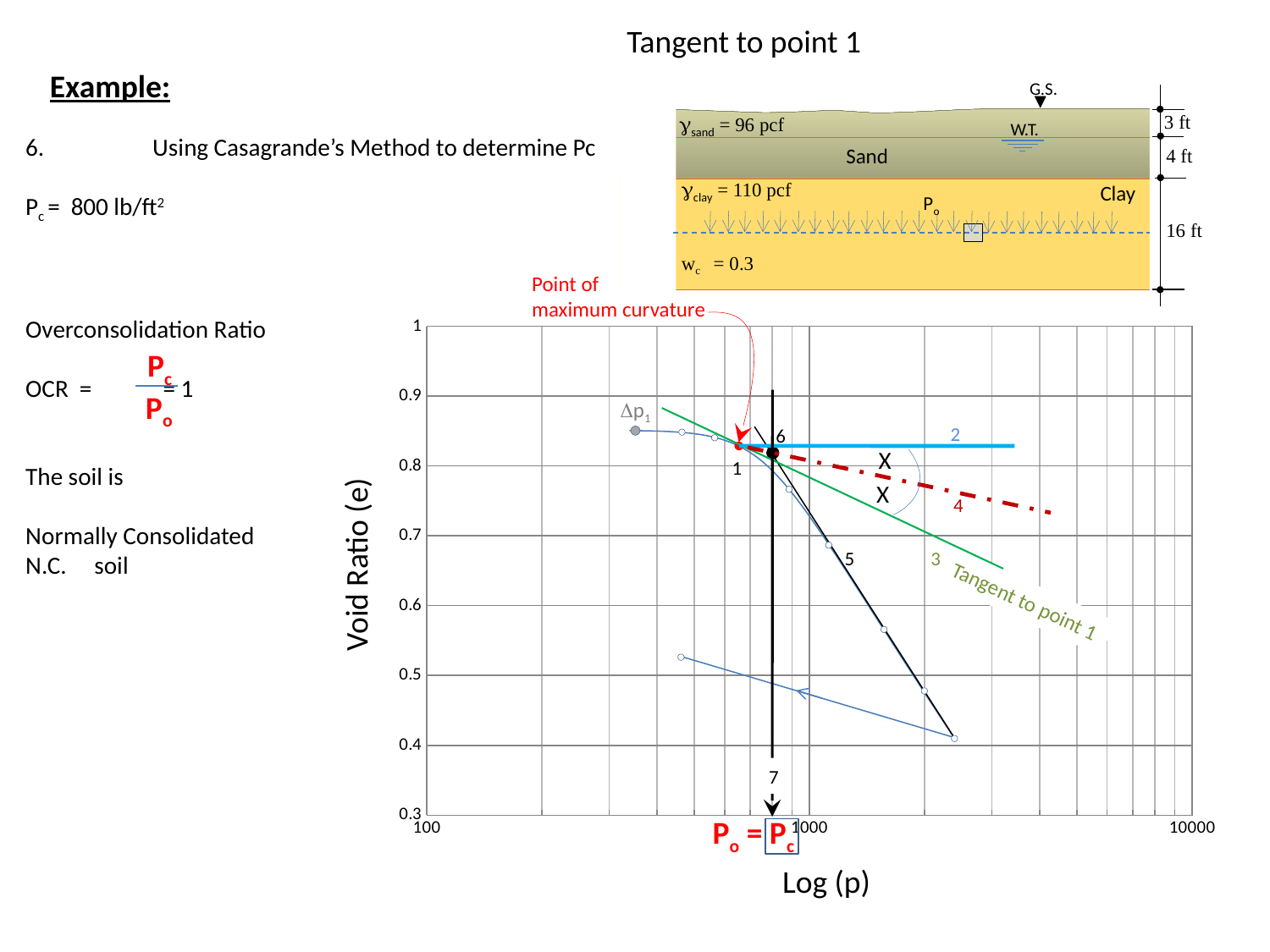
What is the highest tick value shown on the vertical axis? 1 Is the void ratio at point 1 (the point of maximum curvature) greater or less than 0.8? greater Along the main loading curve, does the void ratio rise or fall as p increases? fall What kind of chart is shown on the slide? line chart Which has the higher void ratio: the point labelled Δp1 or the point labelled 5? Δp1 Is the void ratio of the point labelled Δp1 greater or less than 0.8? greater Is the void ratio of the lowest point on the loading curve greater or less than 0.5? less What is the label of the horizontal axis of the chart? Log (p) What is the label of the vertical axis of the chart? Void Ratio (e) Which has the lower void ratio: point 1 or point 5? point 5